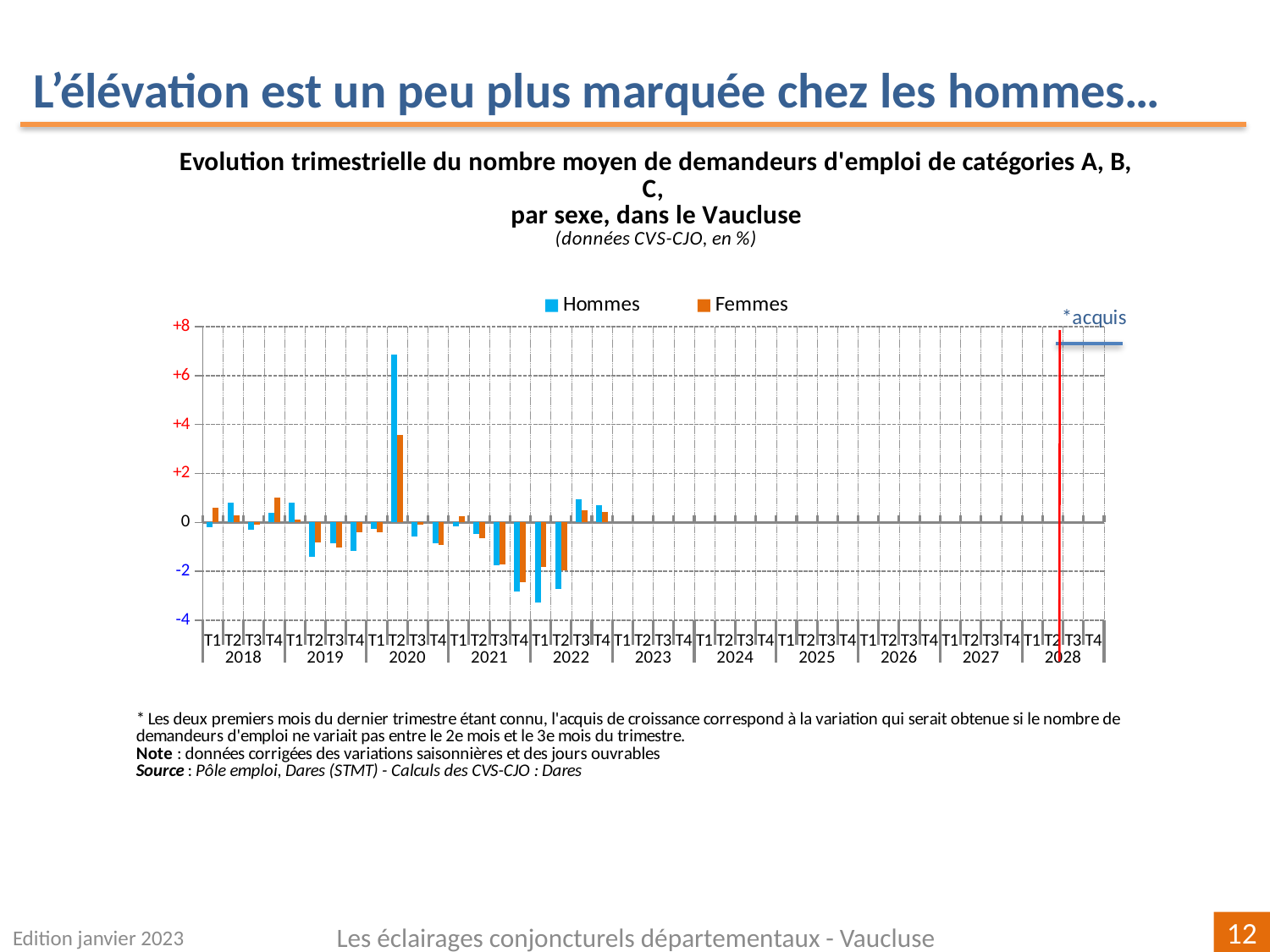
How many series does the legend list? 2 Is the Hommes value for T2 2020 greater or less than +6? greater In which quarter does the Hommes series reach its lowest value? T1 2022 Which two series are listed in the legend? Hommes and Femmes Which colour represents the Hommes series? blue Is the Femmes value for T4 2021 greater or less than -2? less In T1 2022, which series has the lower value, Hommes or Femmes? Hommes Is the Femmes value for T2 2020 greater or less than +4? less In T2 2020, which series has the larger value, Hommes or Femmes? Hommes In which quarter does the Hommes series reach its highest value? T2 2020 What kind of chart is shown on the slide? bar chart